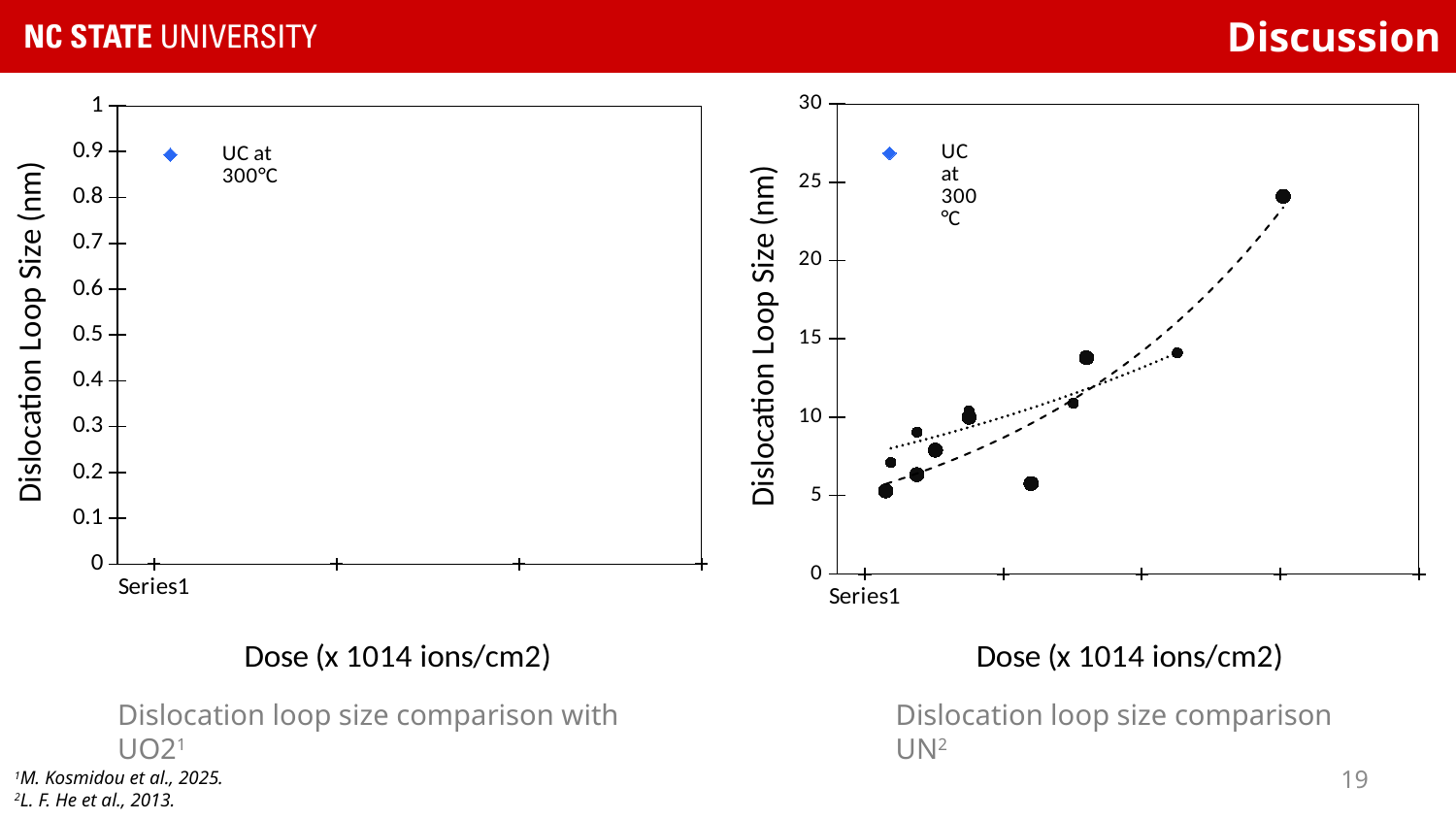
What is the maximum value shown on the y axis of the right-hand chart? 30 How many fitted trend lines (dashed and dotted) are drawn on the right-hand chart? 2 On the right-hand chart, is the highest plotted dislocation loop size greater or less than 20? greater On the right-hand chart, is the lowest plotted dislocation loop size greater or less than 10? less How many data points are plotted on the left-hand chart (Dislocation loop size comparison with UO2)? 0 How many series does the legend of the right-hand chart list? 1 How many series does the legend of the left-hand chart list? 1 On the right-hand chart, do the dislocation loop sizes generally rise or fall as dose increases along the x axis? rise What kind of chart is the right-hand chart (Dislocation loop size comparison UN)? scatter chart What is the maximum value shown on the y axis of the left-hand chart (Dislocation loop size comparison with UO2)? 1 On the right-hand chart, is the highest plotted point greater or less than 25? less What is the legend entry shown on the right-hand chart? UC at 300 °C